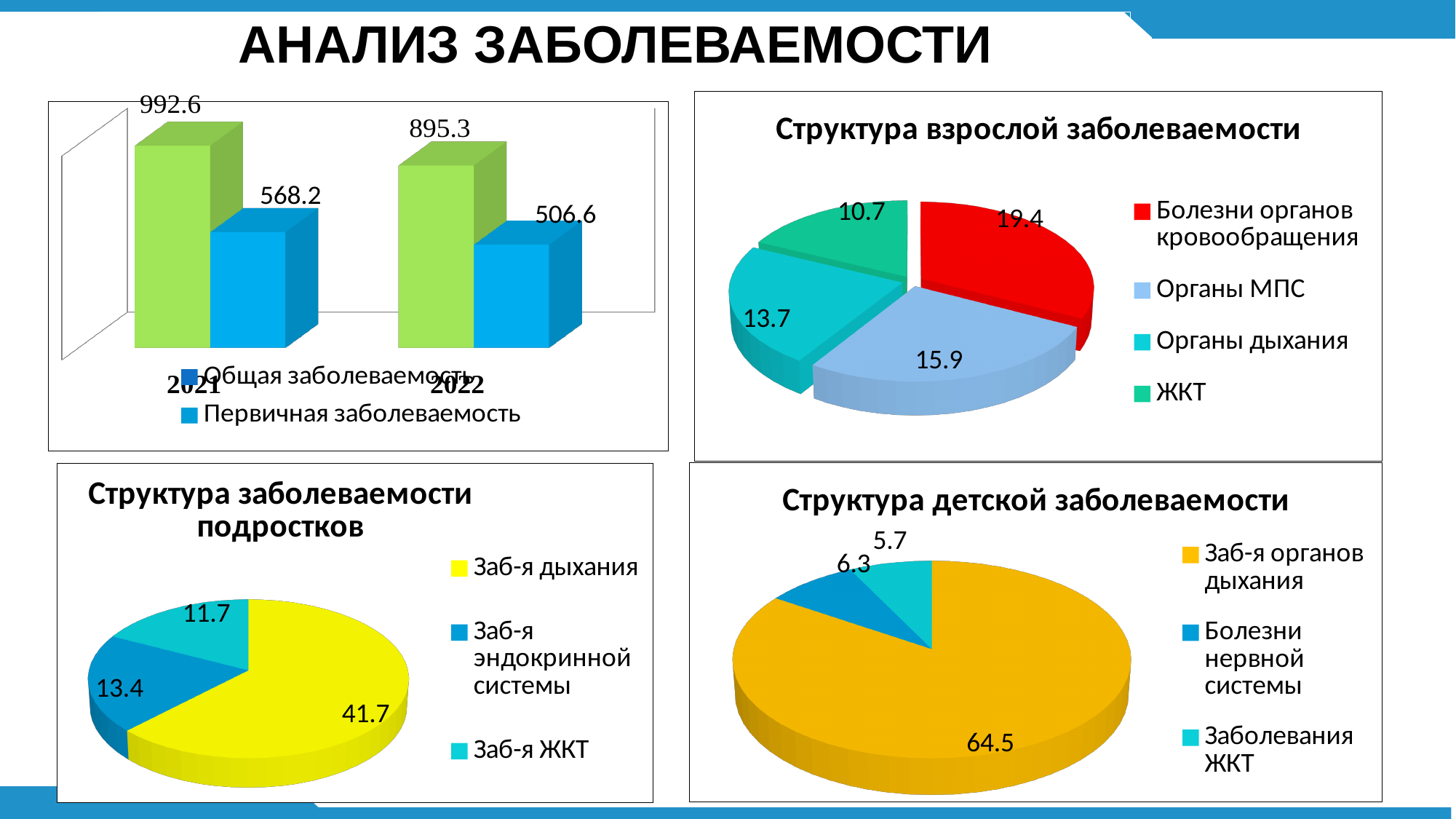
What kind of chart is the top-left chart? bar chart In the top-left bar chart, by how much did Общая заболеваемость change from 2021 to 2022? 97.3 In the chart 'Структура заболеваемости подростков', what is the value for Заб-я эндокринной системы? 13.4 In the top-left bar chart, does Первичная заболеваемость rise or fall from 2021 to 2022? fall In the chart 'Структура взрослой заболеваемости', what is the value for Органы дыхания? 13.7 In the top-left bar chart, what is the value of Общая заболеваемость for 2021? 992.6 In the chart 'Структура детской заболеваемости', which is larger: Болезни нервной системы or Заболевания ЖКТ? Болезни нервной системы How many series does the legend of the top-left bar chart list? 2 In the chart 'Структура взрослой заболеваемости', which category has the largest slice? Болезни органов кровообращения In the chart 'Структура взрослой заболеваемости', which category has the smallest slice? ЖКТ In the top-left bar chart, what is the value of Первичная заболеваемость for 2022? 506.6 In the chart 'Структура детской заболеваемости', what is the value for Заб-я органов дыхания? 64.5